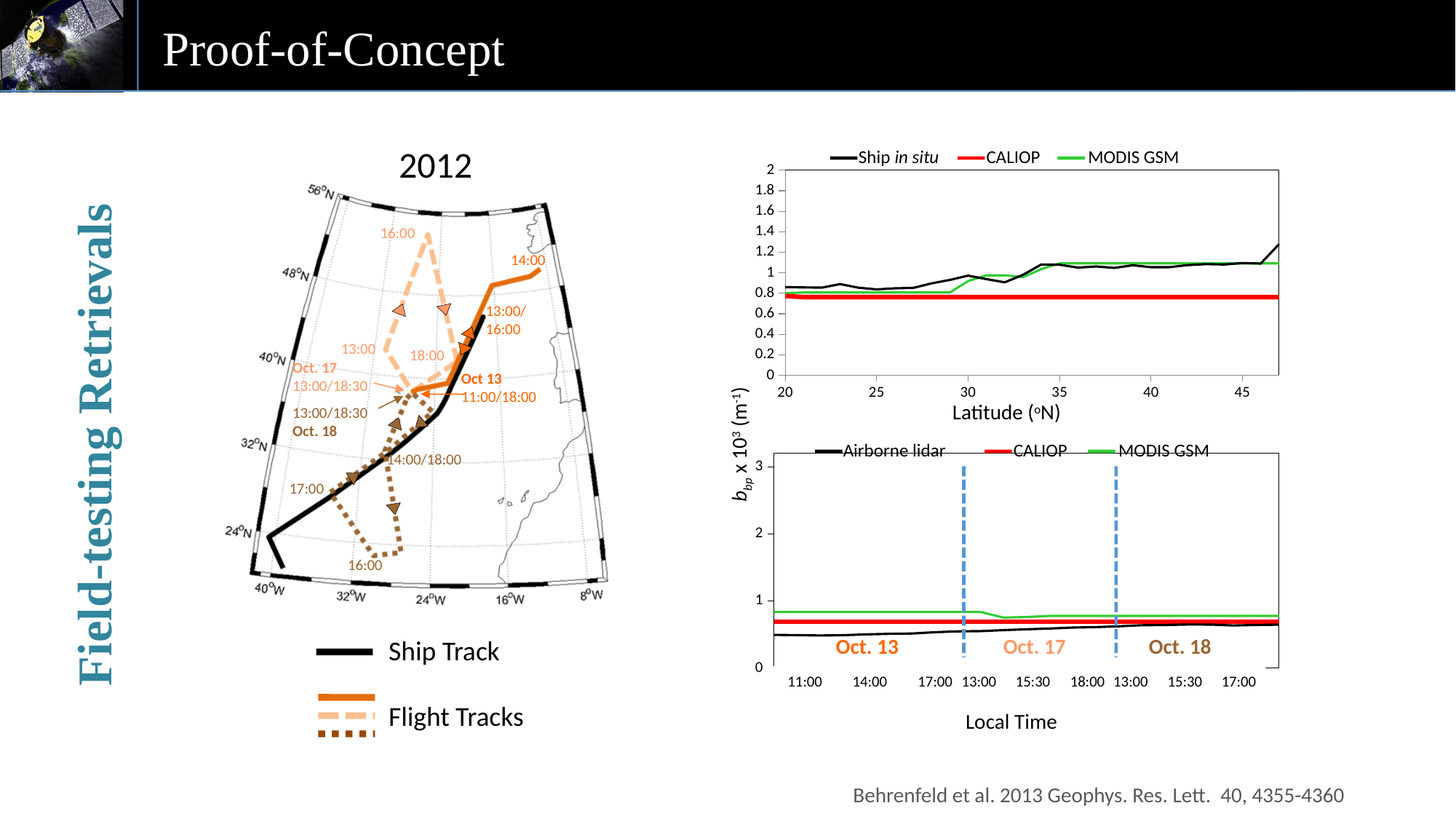
In the top chart (plotted against Latitude), which series is shown in red? CALIOP In the top chart (plotted against Latitude), is the Ship in situ value at 45°N greater or less than 1? greater How many series does the legend of the top chart (plotted against Latitude) list? 3 In the top chart (plotted against Latitude), does the Ship in situ series generally rise or fall as latitude increases from 20 to 45°N? rise What kind of chart is the top chart on the right (plotted against Latitude)? line chart In the top chart (plotted against Latitude), which is larger at 40°N: the Ship in situ value or the CALIOP value? Ship in situ In the bottom chart (plotted against Local Time), is the Airborne lidar value at 11:00 on Oct. 13 greater or less than 1? less In the bottom chart (plotted against Local Time), which is larger at 14:00 on Oct. 13: the MODIS GSM value or the Airborne lidar value? MODIS GSM In the bottom chart (plotted against Local Time), how many dates are labelled along the x axis? 3 How many series does the legend of the bottom chart (plotted against Local Time) list? 3 What is the x-axis title of the bottom chart on the right? Local Time In the top chart (plotted against Latitude), is the CALIOP value at 30°N greater or less than 0.8? less